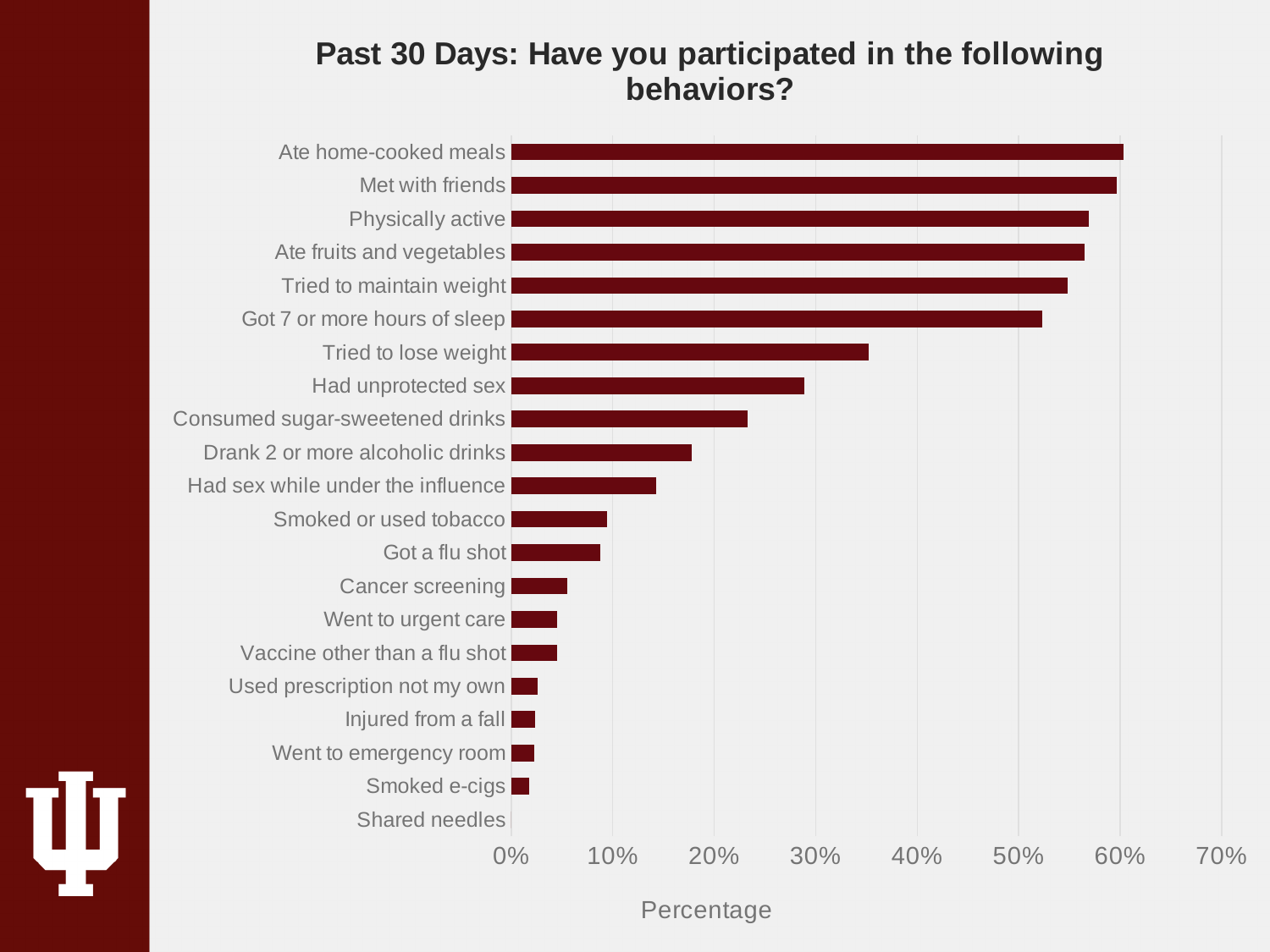
Do the bar values rise or fall going from the top of the chart to the bottom? fall What is the label of the horizontal axis? Percentage Is the value for 'Consumed sugar-sweetened drinks' greater or less than 20%? greater Is the value for 'Got 7 or more hours of sleep' greater or less than 50%? greater Which is larger, the value for 'Tried to lose weight' or the value for 'Had unprotected sex'? Tried to lose weight Which behavior has the lowest value on the chart? Shared needles Which is larger, the value for 'Drank 2 or more alcoholic drinks' or the value for 'Had sex while under the influence'? Drank 2 or more alcoholic drinks Is the value for 'Got a flu shot' greater or less than 10%? less How many behaviors are listed on the chart? 21 What kind of chart is shown on the slide? bar chart